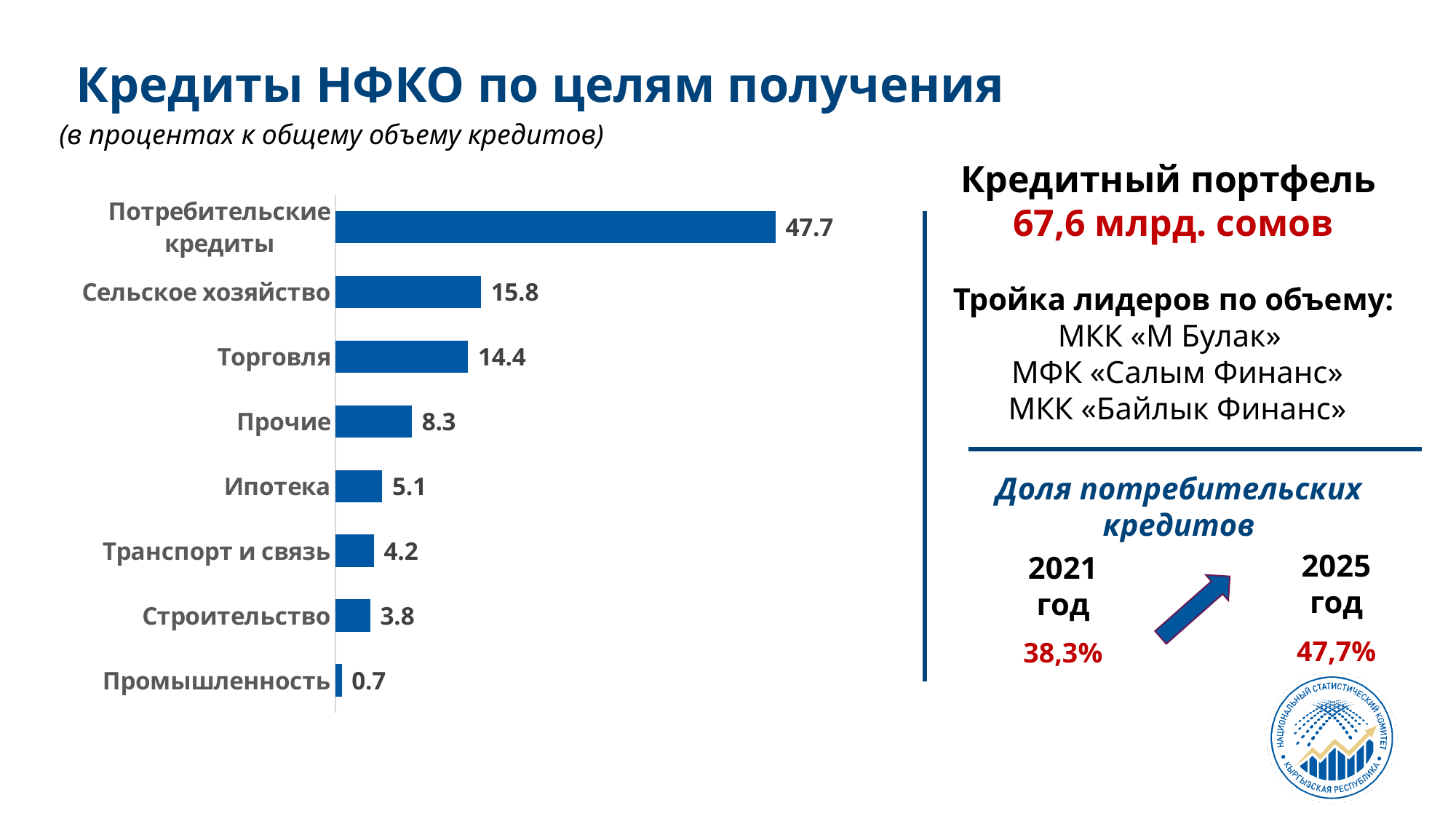
Which category has the lowest value? Промышленность What is the difference between the values for Потребительские кредиты and Прочие? 39.4 What is the value for Строительство? 3.8 What is the difference between the values for Сельское хозяйство and Торговля? 1.4 What is the value for Сельское хозяйство? 15.8 What kind of chart is shown on the slide? bar chart Which is larger, the value for Транспорт и связь or the value for Строительство? Транспорт и связь What is the value for Ипотека? 5.1 What is the value for Потребительские кредиты? 47.7 How many categories are shown in the chart? 8 What is the subtitle shown under the slide title? (в процентах к общему объему кредитов) Which category has the highest value? Потребительские кредиты